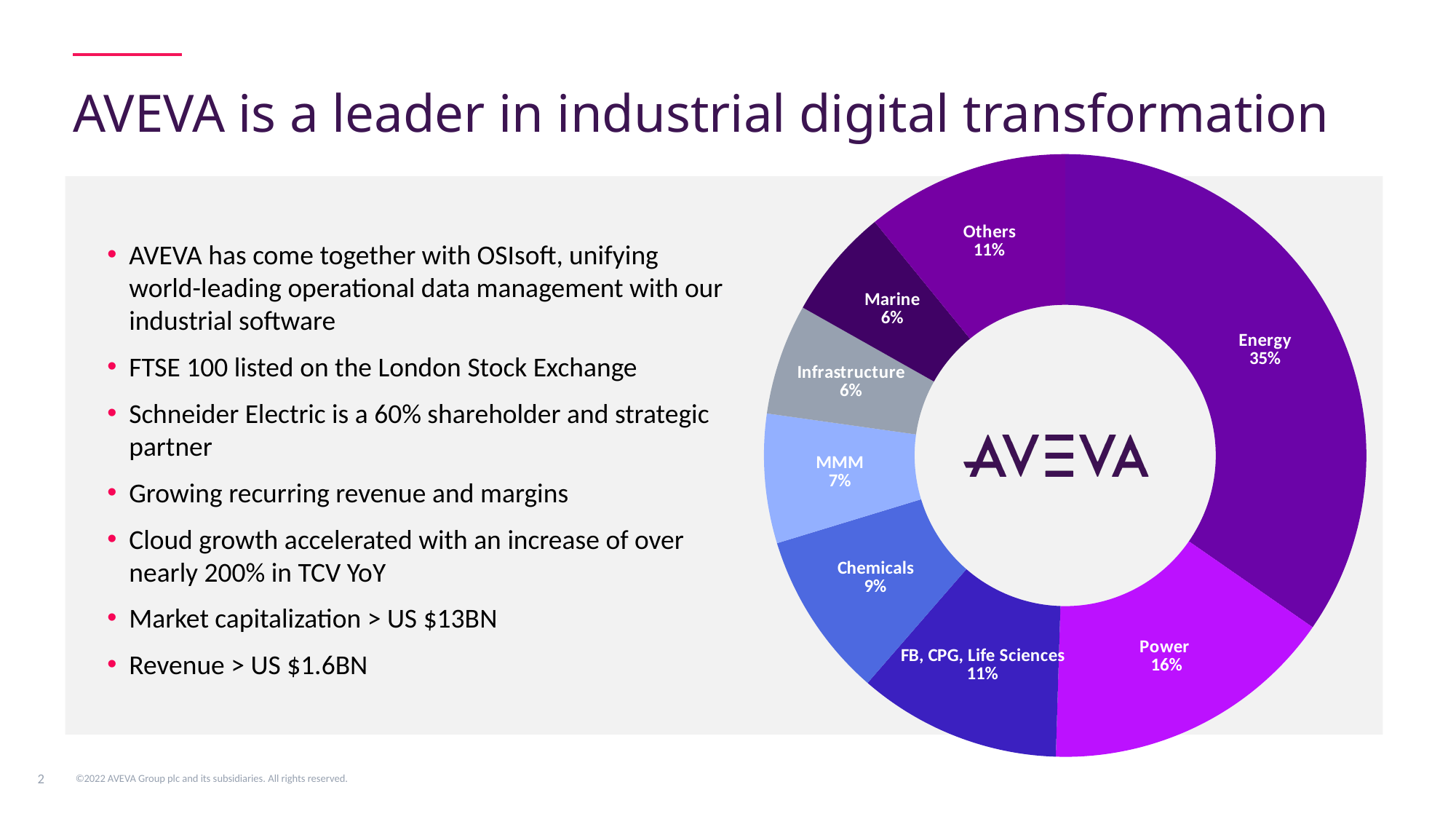
Which segment of the pie chart is the largest? Energy Which is larger in the pie chart, Chemicals or MMM? Chemicals What logo appears in the centre of the pie chart? AVEVA What kind of chart is shown on the slide? Doughnut (ring) chart What percentage is shown for Chemicals in the pie chart? 9% What share of the pie chart does Energy account for? 35% What percentage is shown for Power in the pie chart? 16% How many segments does the pie chart have? 8 What percentage is shown for MMM in the pie chart? 7% What is the combined share of Infrastructure and Marine in the pie chart? 12% What percentage is shown for FB, CPG, Life Sciences in the pie chart? 11% What is the difference in percentage points between Energy and Power in the pie chart? 19